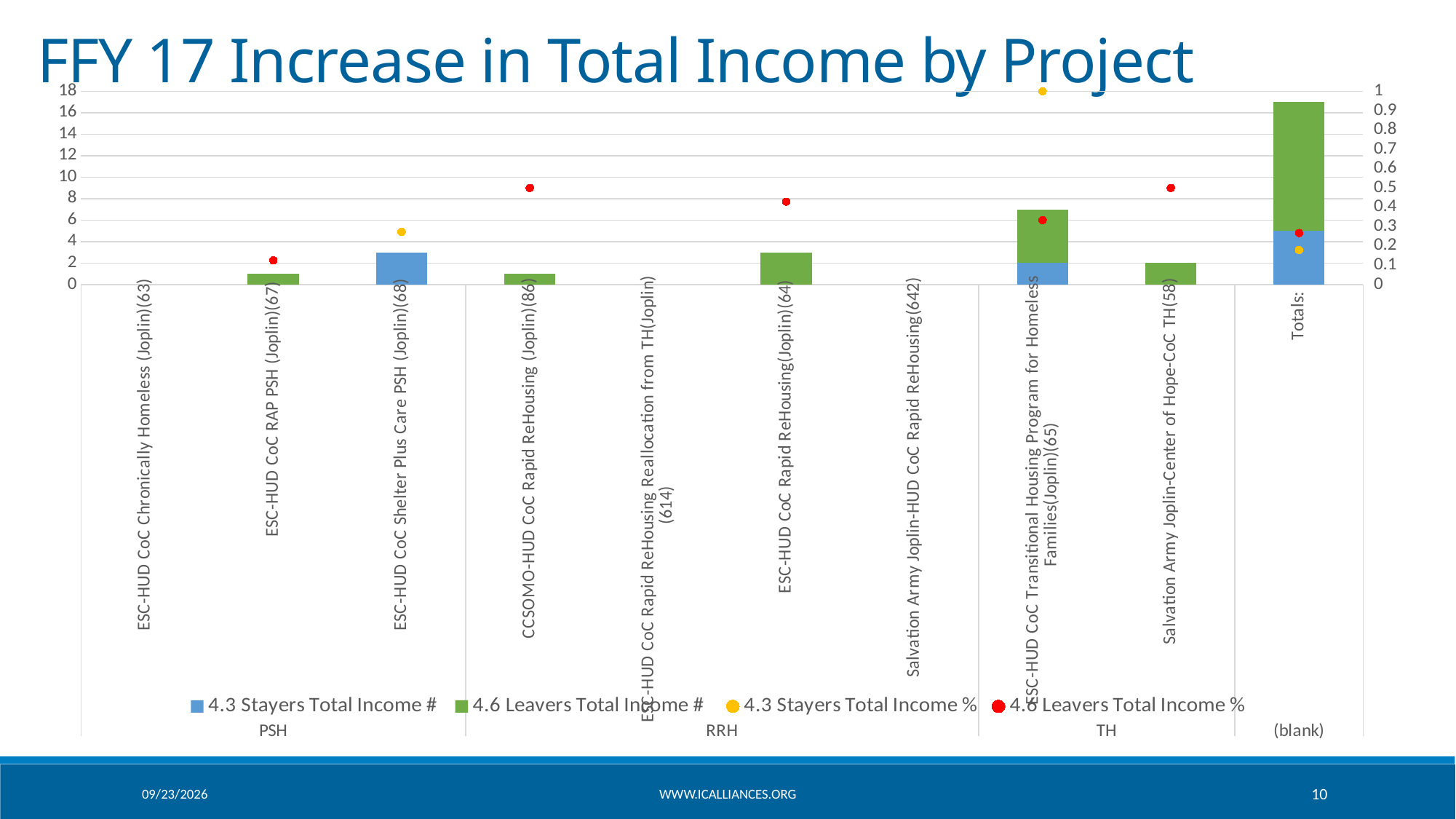
What is the title of the chart? FFY 17 Increase in Total Income by Project What is the 4.6 Leavers Total Income # value for Salvation Army Joplin-Center of Hope-CoC TH(58)? 2 What is the 4.3 Stayers Total Income # value for ESC-HUD CoC Transitional Housing Program for Homeless Families(Joplin)(65)? 2 Which has the taller bar: ESC-HUD CoC Shelter Plus Care PSH (Joplin)(68) or ESC-HUD CoC RAP PSH (Joplin)(67)? ESC-HUD CoC Shelter Plus Care PSH (Joplin)(68) Is the total height of the Totals: stacked bar greater or less than 16? greater How many project categories (including Totals) are shown along the x axis? 10 Which category has the tallest stacked bar? Totals: Is the 4.3 Stayers Total Income # value for ESC-HUD CoC Shelter Plus Care PSH (Joplin)(68) greater or less than 2? greater How many series does the legend list? 4 Which colour represents the 4.6 Leavers Total Income # series? green What kind of chart is shown on the slide? combination chart: stacked bar chart with dot markers Excluding the Totals bar, which project has the tallest stacked bar? ESC-HUD CoC Transitional Housing Program for Homeless Families(Joplin)(65)